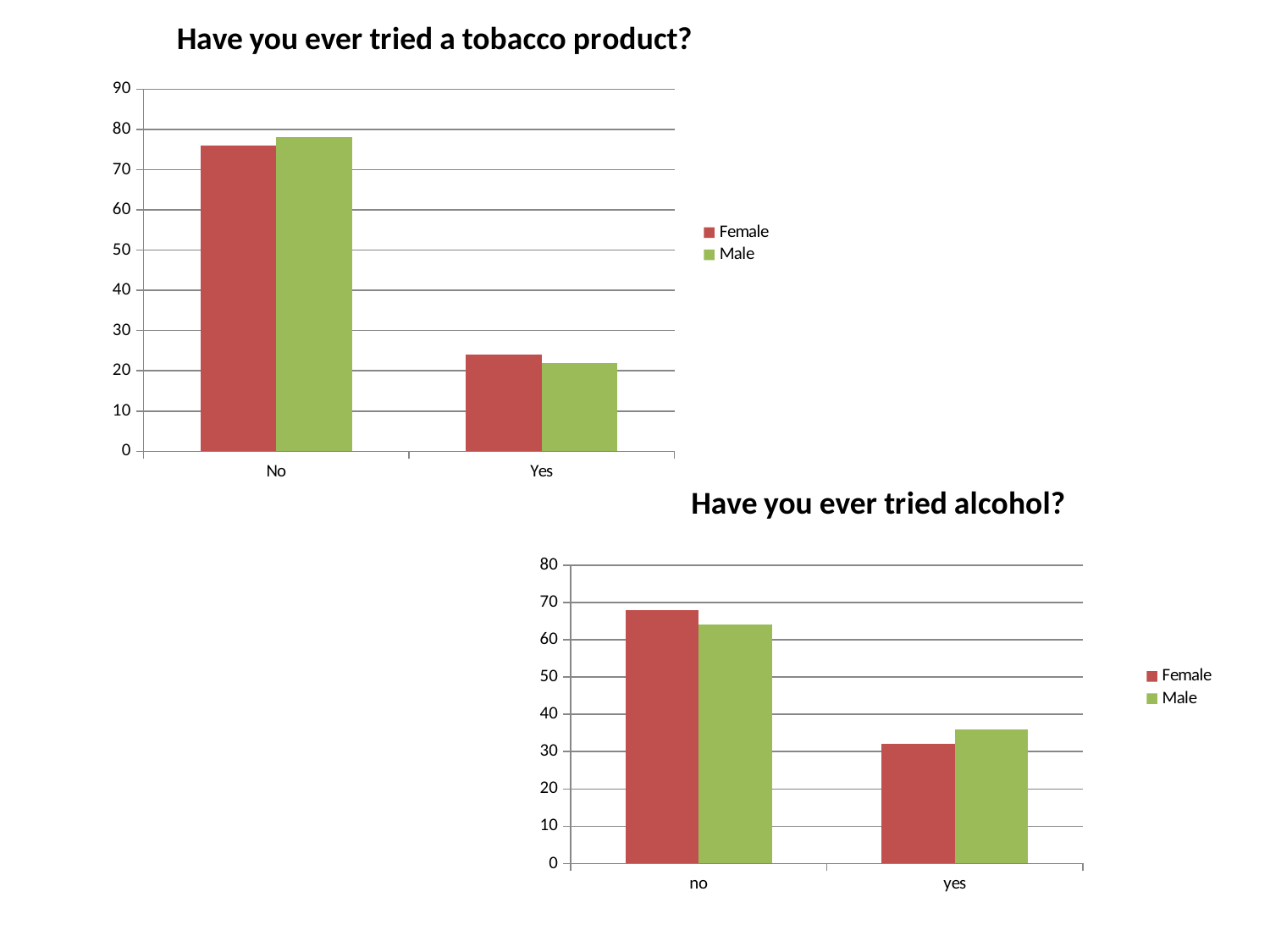
In the 'Have you ever tried a tobacco product?' chart, how many categories are shown on the x axis? 2 In the 'Have you ever tried alcohol?' chart, is the Female value for no greater or less than 60? greater In the 'Have you ever tried a tobacco product?' chart, how many series does the legend list? 2 In the 'Have you ever tried a tobacco product?' chart, is the Male value for No greater or less than 70? greater In the 'Have you ever tried a tobacco product?' chart, is the Male value for Yes greater or less than 30? less What type of chart is the 'Have you ever tried a tobacco product?' chart? bar chart In the 'Have you ever tried alcohol?' chart, what are the two legend entries? Female and Male In the 'Have you ever tried a tobacco product?' chart, which category has the higher Female value, No or Yes? No In the 'Have you ever tried alcohol?' chart, which series has the larger value for no, Female or Male? Female What colour represents the Female series in both charts? red In the 'Have you ever tried alcohol?' chart, which series has the larger value for yes, Female or Male? Male